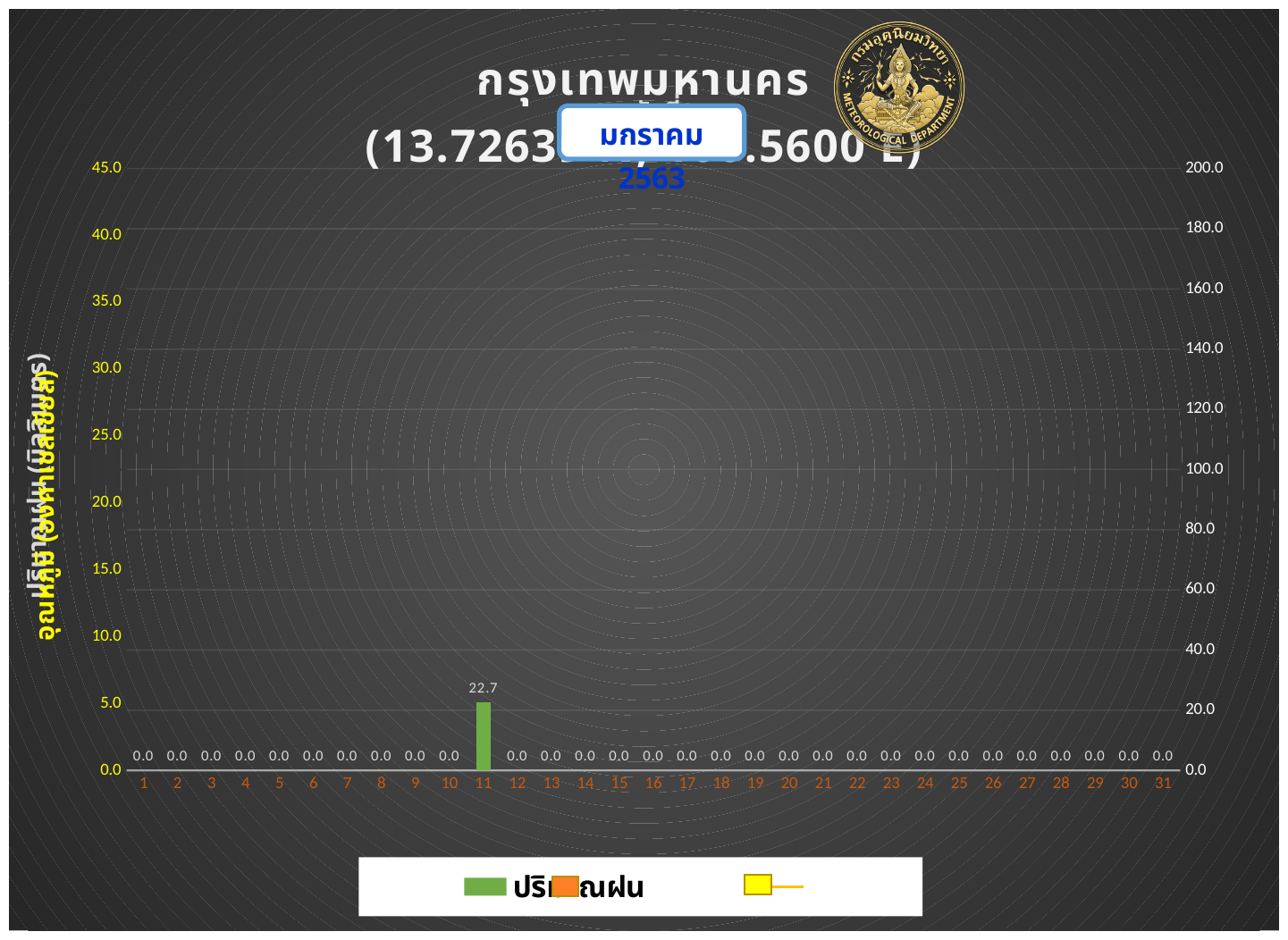
How many days are shown on the x axis? 31 What is the difference between the value for day 11 and the value for day 12? 22.7 Which day has the highest value? 11 What kind of chart is this? bar chart What is the value of the bar for day 11? 22.7 What is the value shown for day 31? 0.0 Which is larger, the value for day 11 or the value for day 20? day 11 What is the value shown for day 1? 0.0 Is the value for day 11 greater or less than 20.0 on the right-hand axis? greater What is the highest tick value on the right-hand axis? 200.0 What colour is the bar plotted for day 11? green What is the value shown for day 15? 0.0